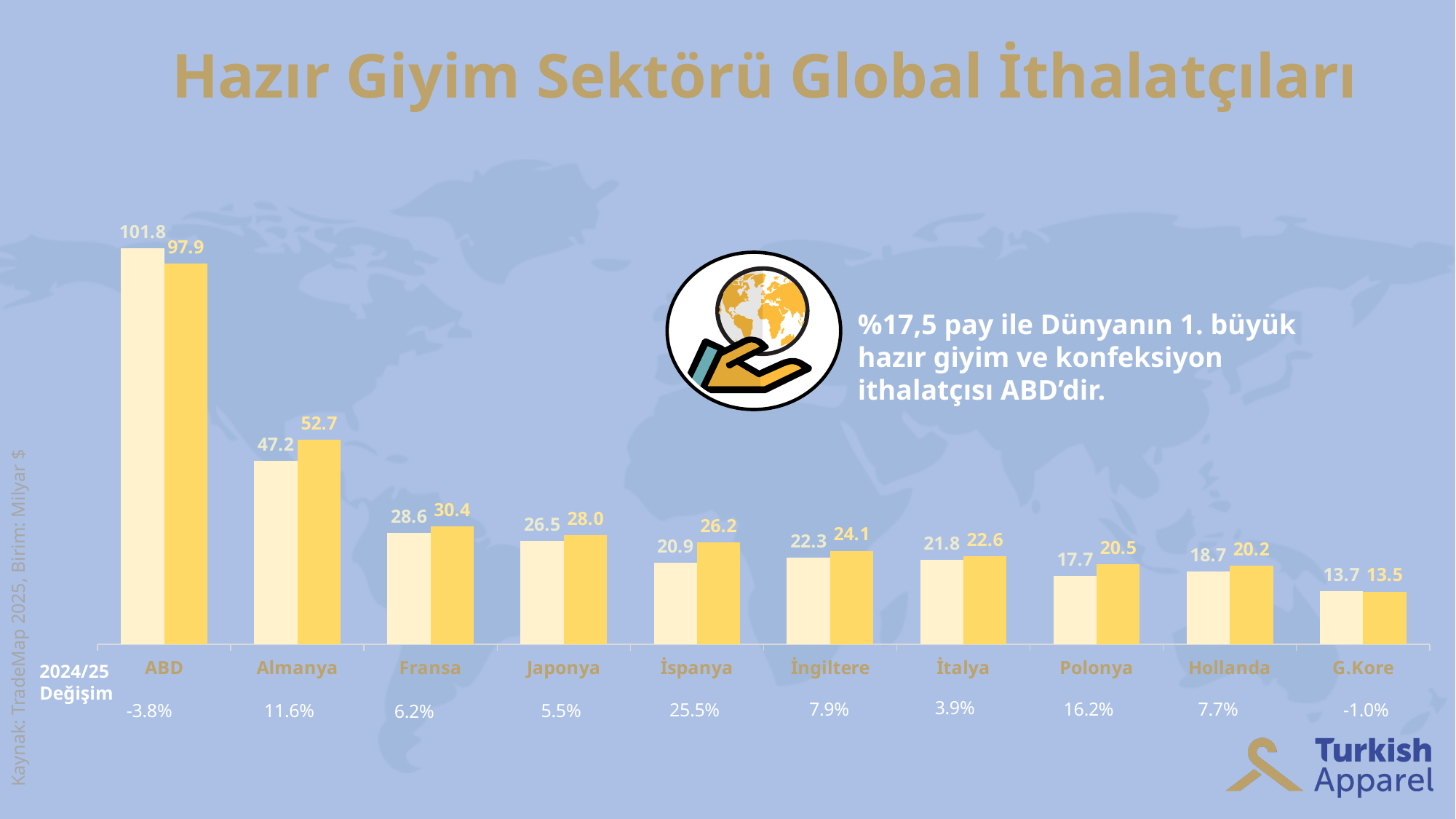
What is the value of the darker (right-hand) bar for İspanya? 26.2 What is the title of the chart on the slide? Hazır Giyim Sektörü Global İthalatçıları What is the value of the lighter (left-hand) bar for ABD? 101.8 What is the value of the darker (right-hand) bar for Almanya? 52.7 Which is larger: the darker bar for Fransa or the darker bar for Japonya? Fransa How many countries are shown on the x axis of the chart? 10 What is the difference between the two bars for ABD (101.8 and 97.9)? 3.9 Which country has the lowest darker (right-hand) bar value in the chart? G.Kore What is the 2024/25 Değişim value shown for G.Kore? -1.0% Which country has the highest value in the chart? ABD What is the 2024/25 Değişim value shown for Polonya? 16.2% What type of chart is shown on the slide? bar chart